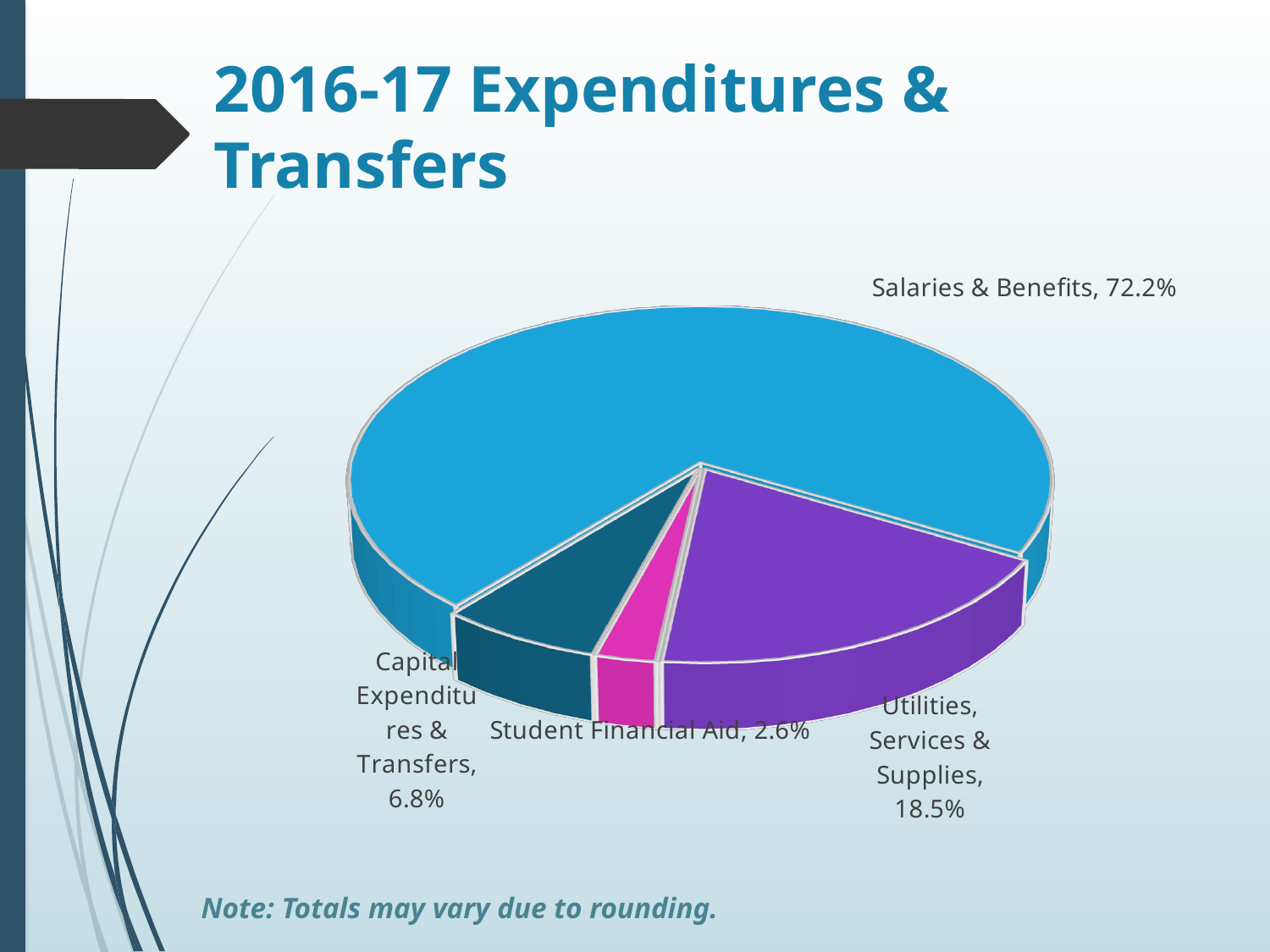
What is the difference in percentage points between Capital Expenditures & Transfers and Student Financial Aid? 4.2 What is the title of the slide containing the chart? 2016-17 Expenditures & Transfers Which category has the smallest share of the pie? Student Financial Aid What percentage is shown for Capital Expenditures & Transfers? 6.8% Which is larger, Utilities, Services & Supplies or Capital Expenditures & Transfers? Utilities, Services & Supplies What kind of chart is shown on the slide? Pie chart What is the difference in percentage points between Salaries & Benefits and Utilities, Services & Supplies? 53.7 How many categories are shown in the pie chart? 4 What percentage is shown for Student Financial Aid? 2.6% What share of 2016-17 Expenditures & Transfers is Salaries & Benefits? 72.2% Which category has the largest share of the pie? Salaries & Benefits What share of the pie is Utilities, Services & Supplies? 18.5%